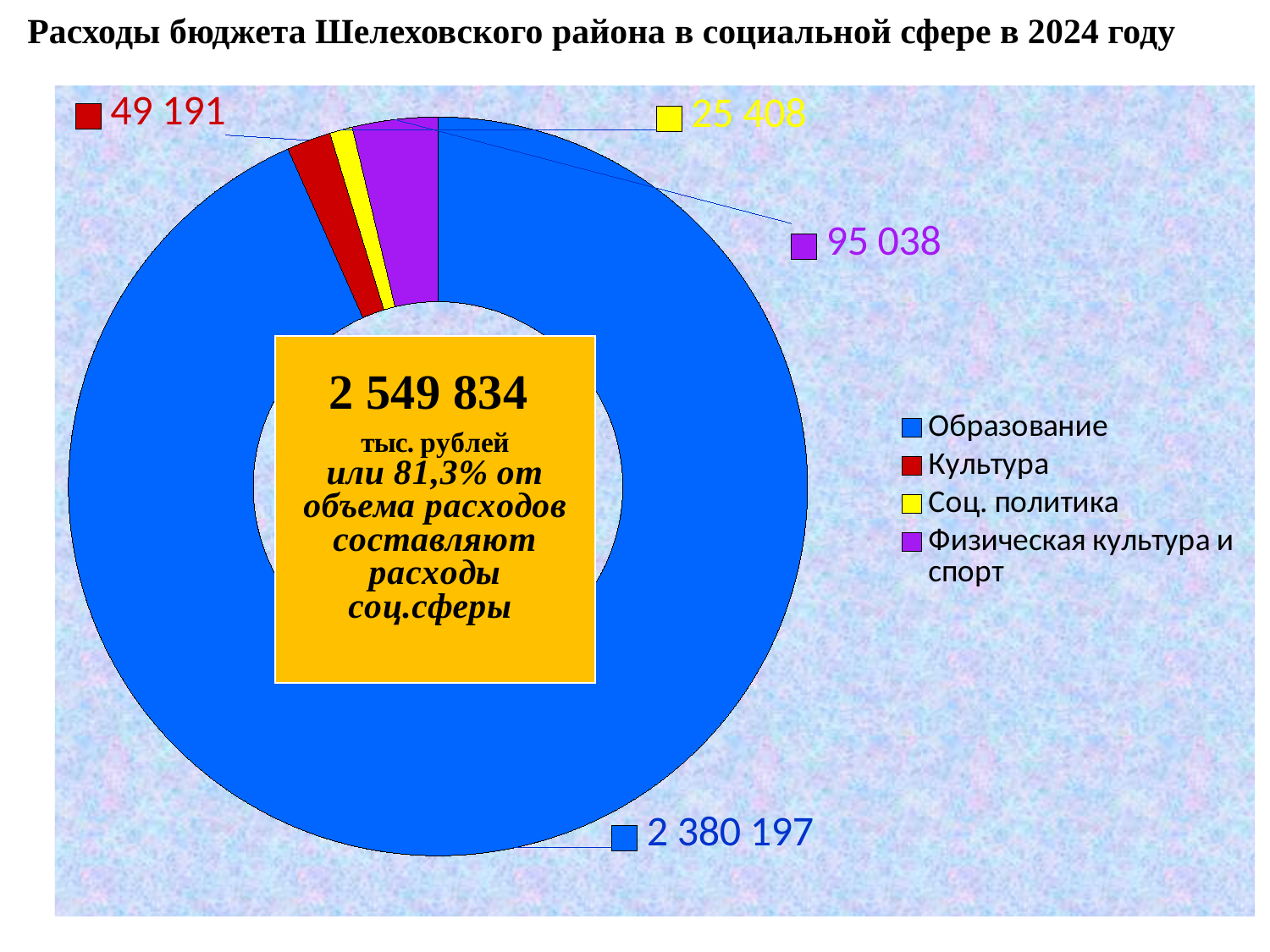
What is the value for Соц. политика in the chart? 25 408 Which category has the smallest value in the chart? Соц. политика What is the difference between the values for Физическая культура и спорт and Культура? 45 847 What is the value for Культура in the chart? 49 191 What is the value for Физическая культура и спорт in the chart? 95 038 What is the value for Образование in the chart? 2 380 197 How many categories does the chart show? 4 What kind of chart is shown on the slide? pie chart (doughnut) Which category has the largest value in the chart? Образование Which is larger: the value for Культура or the value for Соц. политика? Культура What total is shown in the centre of the chart? 2 549 834 What is the title of the slide? Расходы бюджета Шелеховского района в социальной сфере в 2024 году